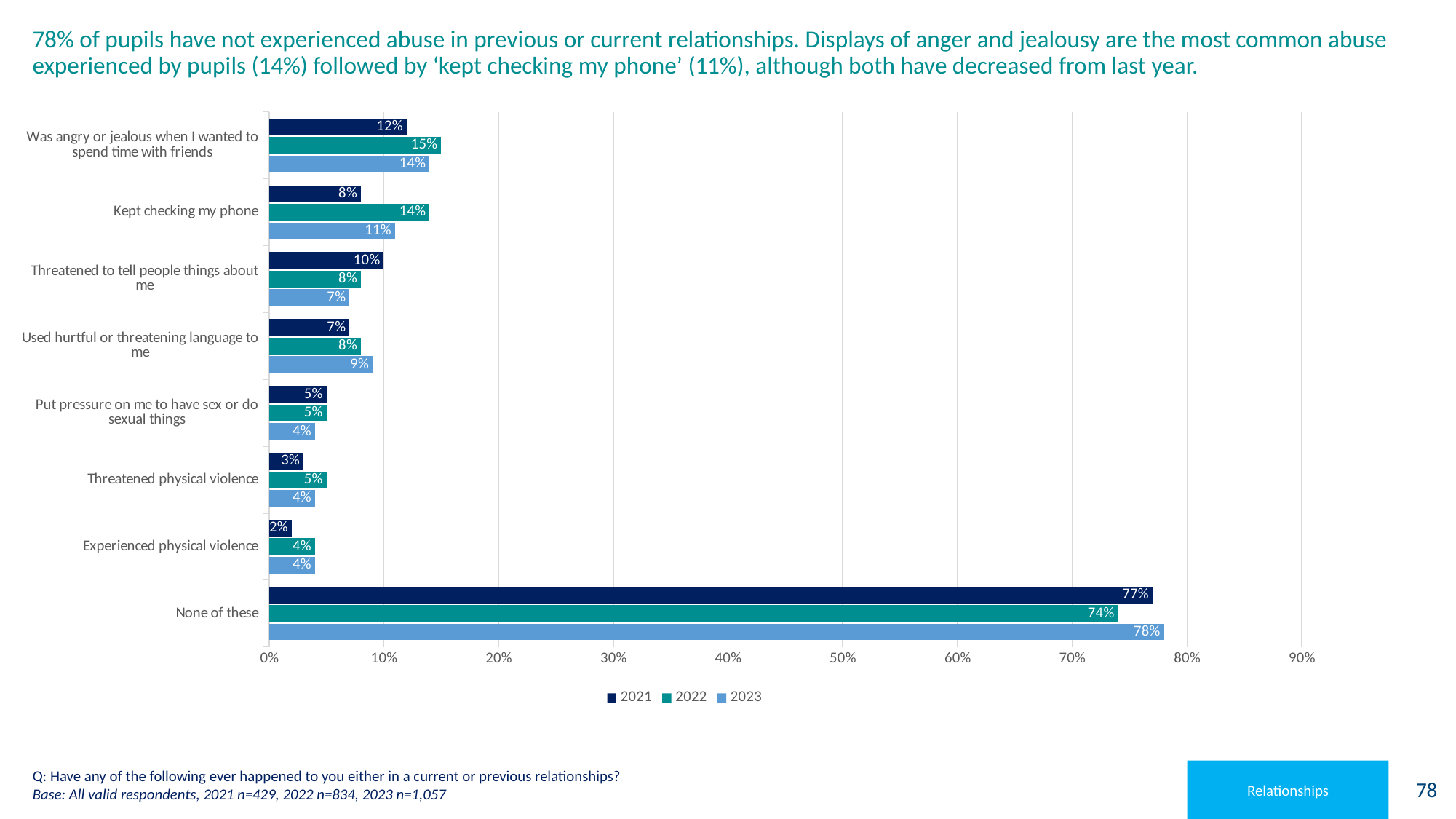
How many categories are shown on the chart? 8 What is the 2022 value for 'None of these'? 74% Which category has the lowest 2021 value? Experienced physical violence Which is larger for 'Used hurtful or threatening language to me': the 2021 value or the 2023 value? 2023 What is the 2023 value for 'Kept checking my phone'? 11% Which category has the highest 2023 value? None of these Which series is shown in the darkest blue colour? 2021 What is the difference between the 2022 and 2023 values for 'Kept checking my phone'? 3% What is the 2021 value for 'Was angry or jealous when I wanted to spend time with friends'? 12% What kind of chart is shown on the slide? Bar chart How many series does the legend list? 3 Is the 2023 value for 'None of these' greater or less than 70%? greater